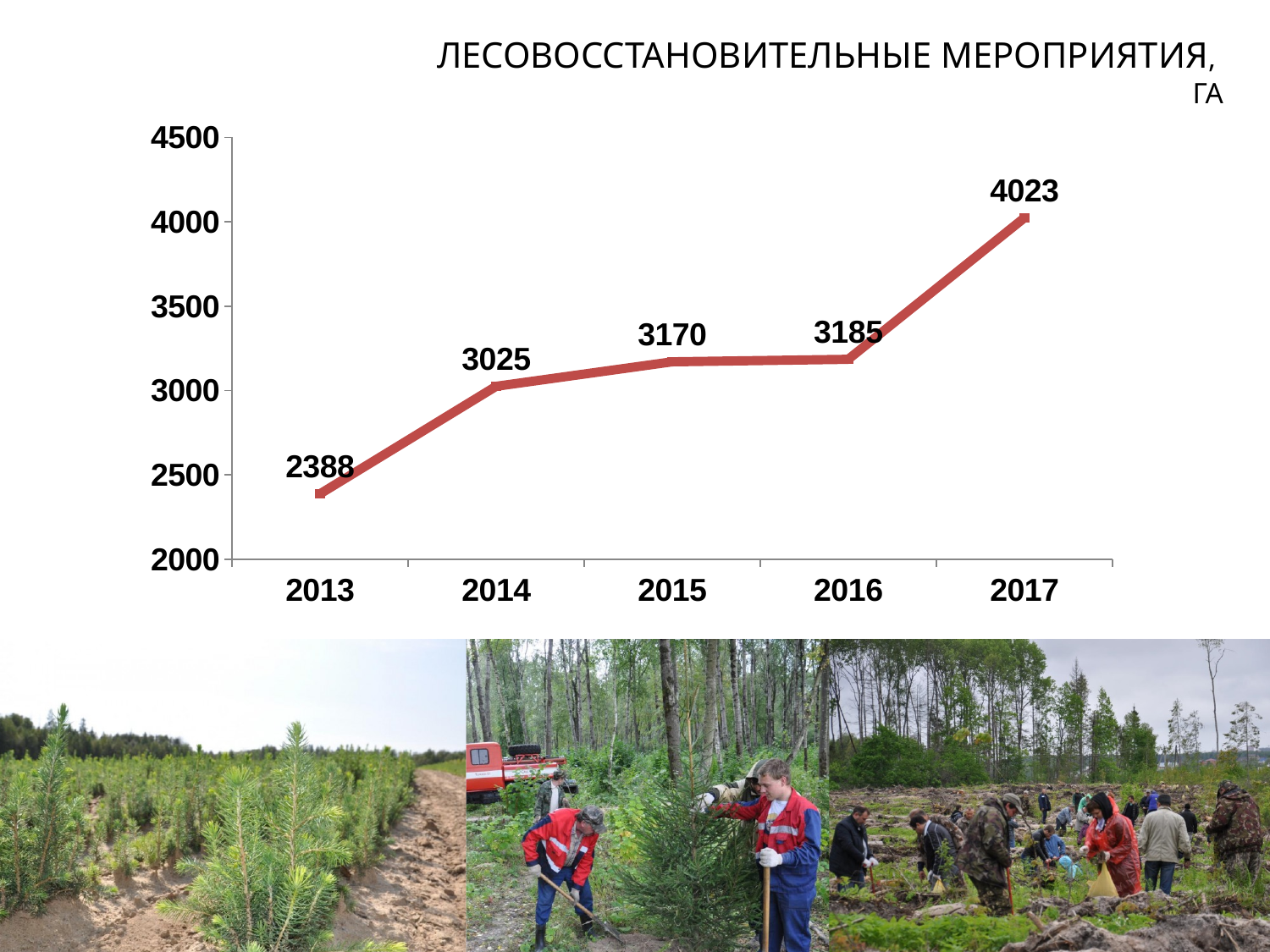
Which year has the lowest value? 2013 What is the value for 2015? 3170 Is the value for 2016 greater or less than 3000? greater Which year has the highest value? 2017 Do the values rise or fall from 2013 to 2017? rise Which is larger, the value for 2014 or the value for 2015? 2015 What is the value for 2017? 4023 What is the value for 2013? 2388 What kind of chart is shown on the slide? line chart How many years are plotted on the chart? 5 What is the difference between the values for 2017 and 2016? 838 What is the difference between the values for 2014 and 2013? 637